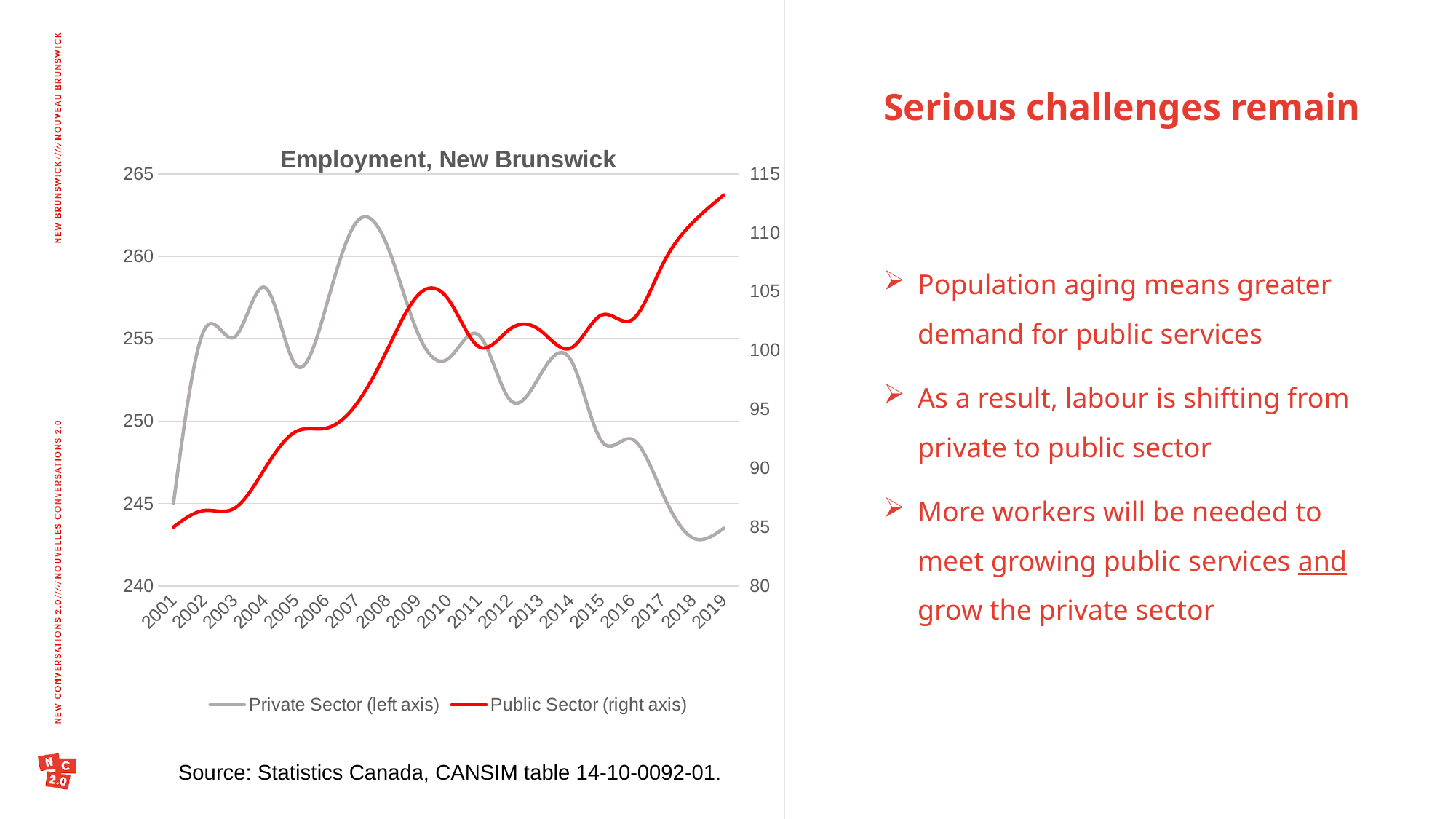
Is the Private Sector value for 2007 greater or less than 260? greater How many series does the chart's legend list? 2 Is the Public Sector value for 2001 greater or less than 90? less In which year does the Public Sector series reach its highest value? 2019 How many years are shown on the x axis of the chart? 19 What is the title of the chart? Employment, New Brunswick Which series is plotted against the right axis? Public Sector Is the Public Sector value for 2019 greater or less than 110? greater What kind of chart is shown on the slide? Line chart In which year does the Private Sector series reach its highest value? 2007 Does the Public Sector series generally rise or fall from 2001 to 2019? Rise In which year is the Public Sector series at its lowest? 2001